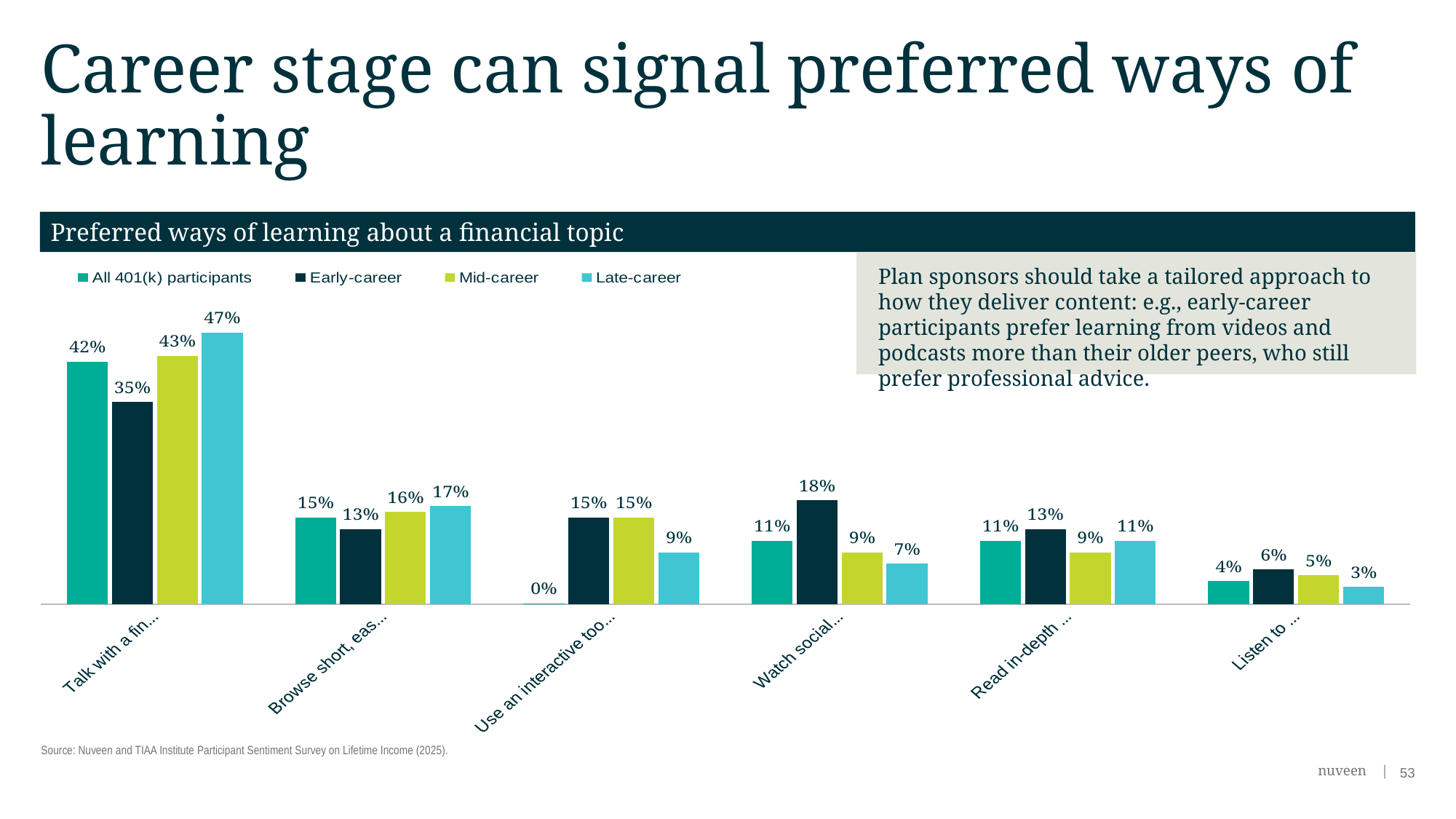
What kind of chart is shown on the slide? Bar chart How many categories are shown on the x axis? 6 What is the difference between the Late-career and Early-career values for the "Talk with a fin..." category? 12% What is the value for All 401(k) participants in the "Use an interactive too..." category? 0% What is the Mid-career value for the "Read in-depth ..." category? 9% In the "Watch social..." category, which is larger: the Early-career value or the Late-career value? Early-career What is the title of the chart? Preferred ways of learning about a financial topic What is the Late-career value for the "Talk with a fin..." category? 47% Which category has the highest Early-career value? Talk with a fin... Which category has the lowest Late-career value? Listen to ... What is the Early-career value for the "Watch social..." category? 18% How many series does the legend list? 4